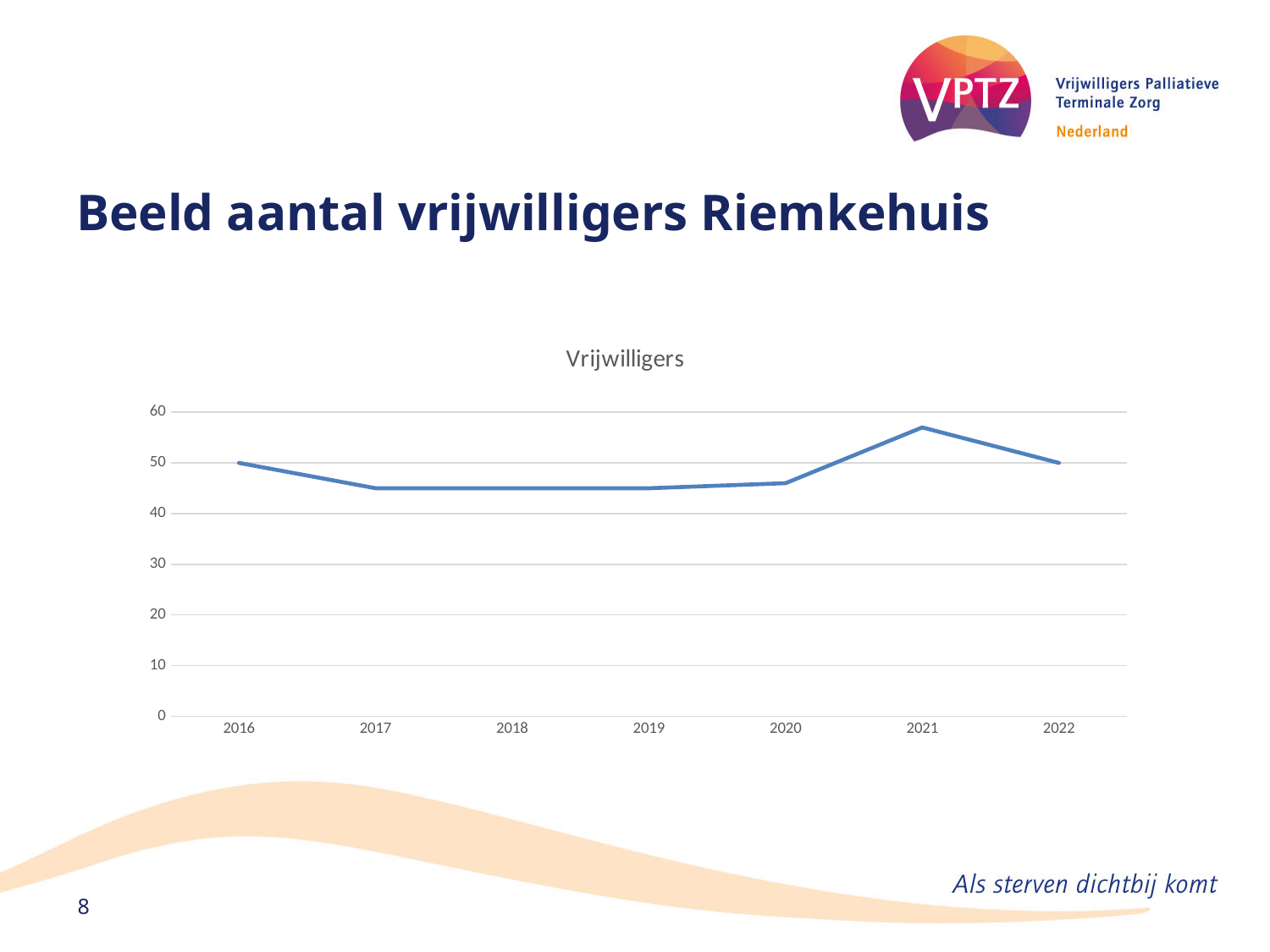
What is the value for 2016? 50 Which is larger, the value for 2016 or the value for 2017? 2016 How many years are plotted on the x axis of the chart? 7 What is the title of the chart? Vrijwilligers Is the value for 2021 greater or less than 50? greater Does the value rise or fall from 2021 to 2022? fall Does the value rise or fall from 2020 to 2021? rise What is the value for 2022? 50 What type of chart is shown on the slide? line chart Is the value for 2017 greater or less than 50? less Which year has the highest value? 2021 Is the value for 2019 greater or less than 40? greater